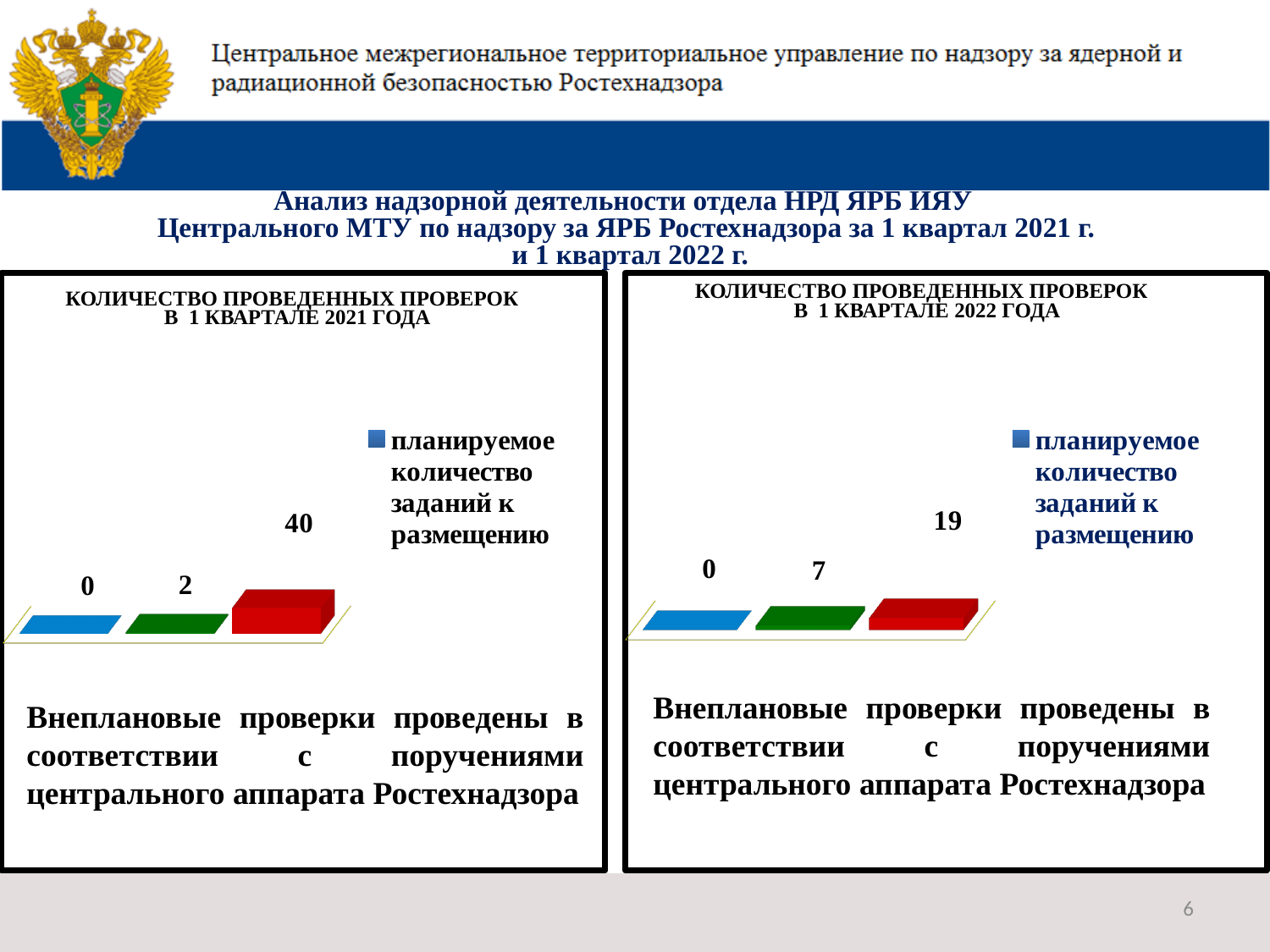
How many bars are plotted in the left chart (1 квартал 2021 года)? 3 How many bars are plotted in the right chart (1 квартал 2022 года)? 3 In the right chart (1 квартал 2022 года), what is the difference between the highest value and the second-highest value? 12 In the left chart (1 квартал 2021 года), what is the total of all three plotted values? 42 In the left chart (1 квартал 2021 года), what is the highest value shown? 40 In the left chart (1 квартал 2021 года), what is the difference between the highest and the lowest value? 40 What kind of chart is shown in the left chart, 'Количество проведенных проверок в 1 квартале 2021 года'? bar chart Which chart has the larger maximum value: the left chart (2021) or the right chart (2022)? the left chart (2021) In the right chart (1 квартал 2022 года), what is the highest value shown? 19